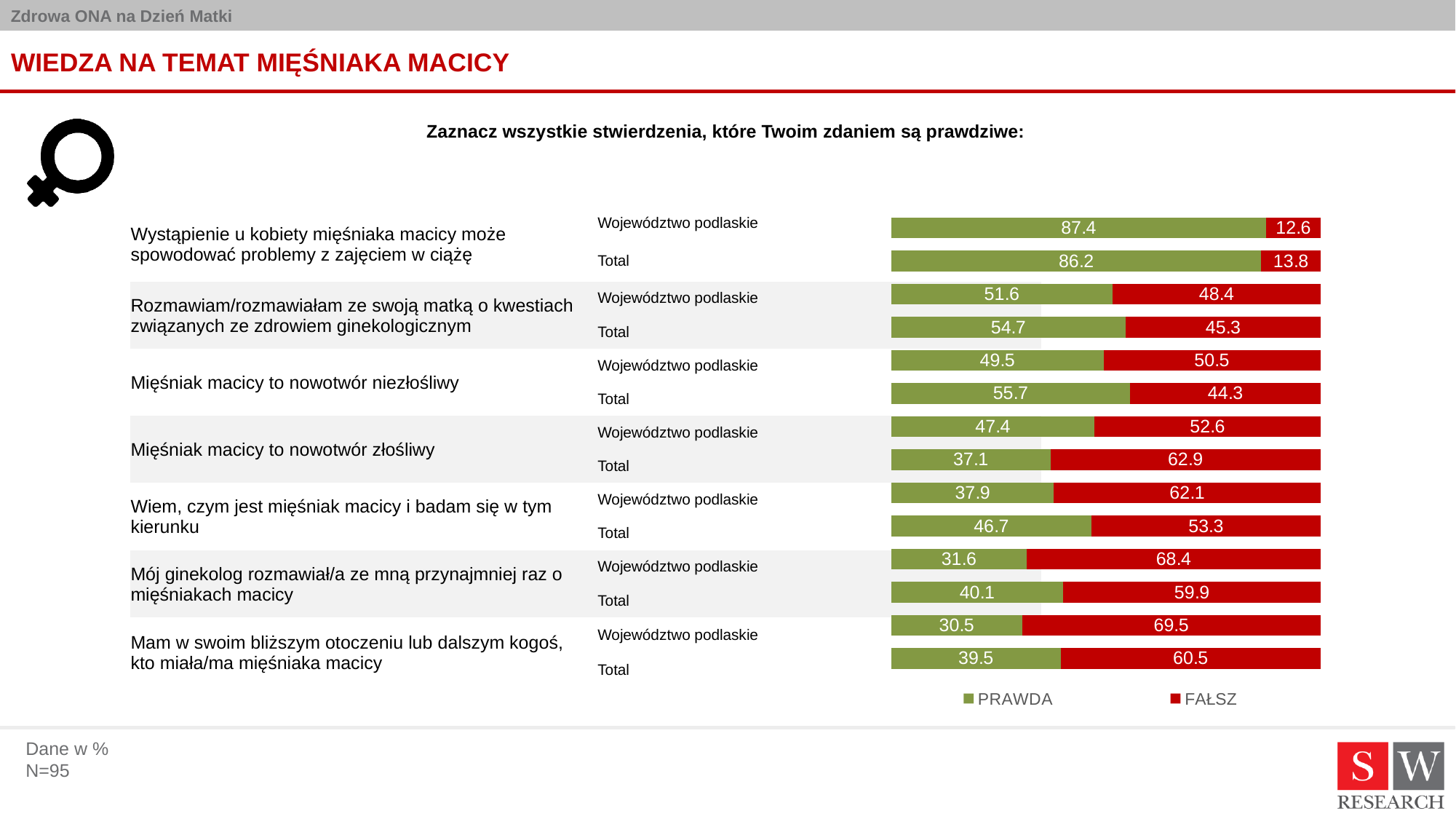
For the statement "Wiem, czym jest mięśniak macicy i badam się w tym kierunku", which is larger: the PRAWDA value for Województwo podlaskie or for Total? Total What is the total of the stacked bar for Total for the statement "Rozmawiam/rozmawiałam ze swoją matką o kwestiach związanych ze zdrowiem ginekologicznym"? 100 How many series does the legend list? 2 What is the difference between the Województwo podlaskie and Total PRAWDA values for the statement "Mięśniak macicy to nowotwór złośliwy"? 10.3 Which colour represents the FAŁSZ series in the chart? Red What kind of chart is shown on the slide? Stacked bar chart What is the PRAWDA value for Total for the statement "Mój ginekolog rozmawiał/a ze mną przynajmniej raz o mięśniakach macicy"? 40.1 What is the PRAWDA value for Województwo podlaskie for the statement "Wystąpienie u kobiety mięśniaka macicy może spowodować problemy z zajęciem w ciążę"? 87.4 Which statement has the lowest PRAWDA value for Total? Mięśniak macicy to nowotwór złośliwy What is the FAŁSZ value for Total for the statement "Mięśniak macicy to nowotwór złośliwy"? 62.9 Which statement has the highest PRAWDA value for Województwo podlaskie? Wystąpienie u kobiety mięśniaka macicy może spowodować problemy z zajęciem w ciążę What is the FAŁSZ value for Województwo podlaskie for the statement "Mam w swoim bliższym otoczeniu lub dalszym kogoś, kto miała/ma mięśniaka macicy"? 69.5